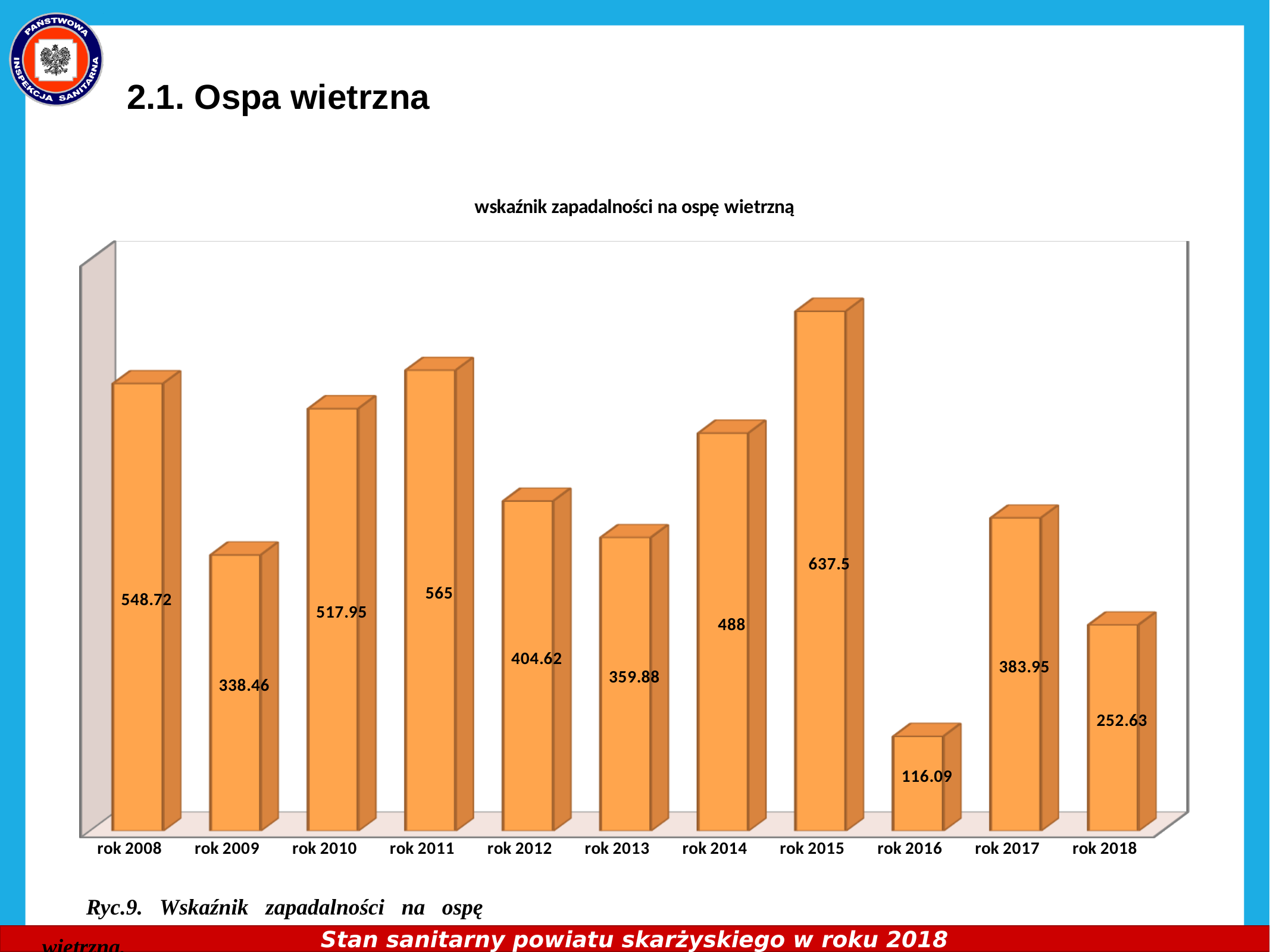
What is the title of the chart? wskaźnik zapadalności na ospę wietrzną Which is larger, the value for rok 2011 or the value for rok 2010? rok 2011 What is the value for rok 2018? 252.63 Which year has the lowest value? rok 2016 Do the values rise or fall from rok 2015 to rok 2016? fall What is the value for rok 2012? 404.62 What is the value for rok 2008? 548.72 What is the value for rok 2015? 637.5 Which year has the highest value? rok 2015 What is the difference between the values for rok 2015 and rok 2016? 521.41 What kind of chart is this? bar chart How many years are shown on the chart? 11